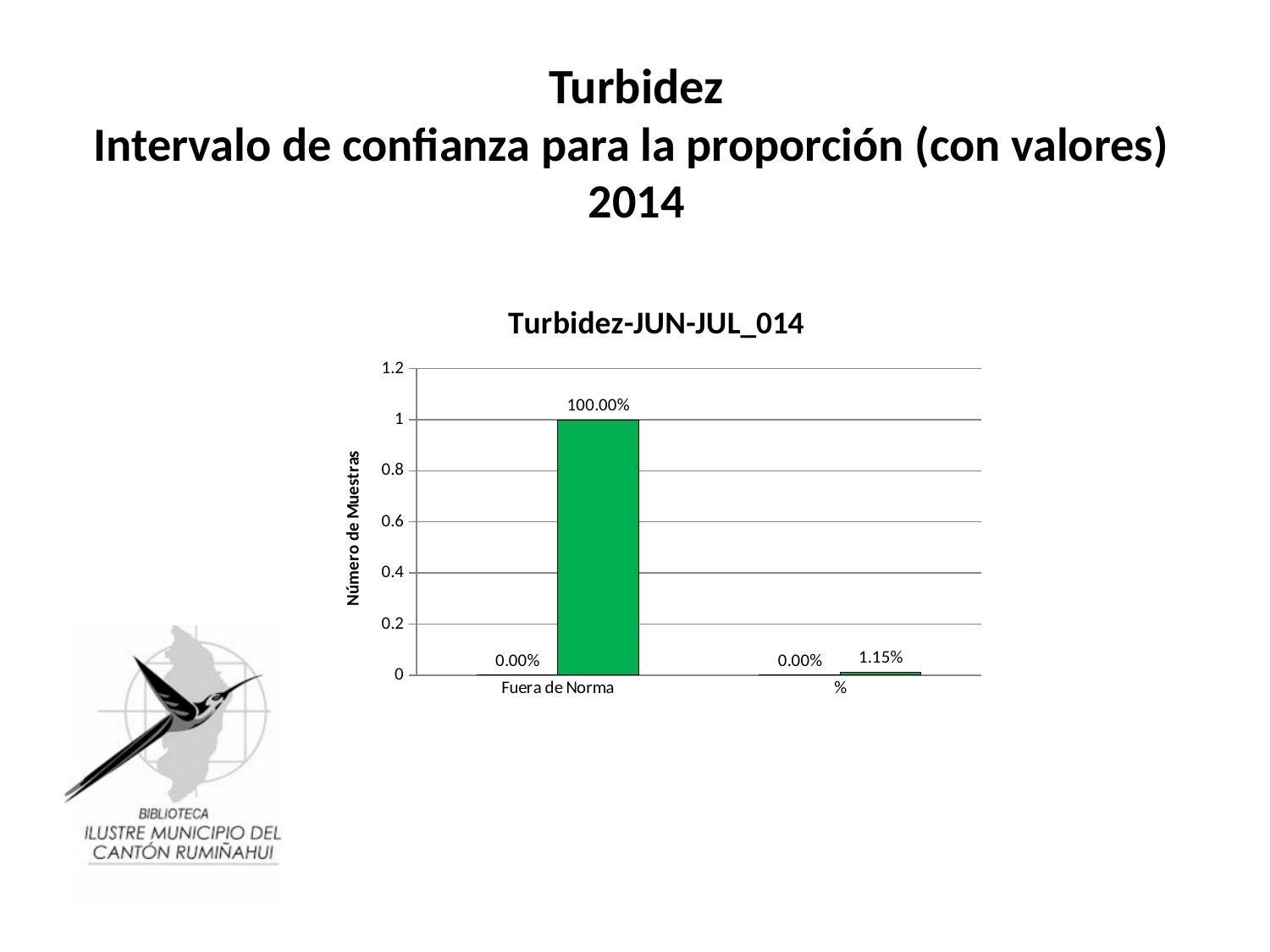
Which category has the larger green bar, 'Fuera de Norma' or '%'? Fuera de Norma What is the data label on the visible green bar in the '%' category? 1.15% Which category contains the tallest bar in the chart? Fuera de Norma What is the label on the vertical axis of the chart? Número de Muestras What is the difference between the data labels 100.00% and 1.15% shown on the chart? 98.85% How many categories are shown on the x axis of the chart? 2 What is the data label on the tallest bar in the chart? 100.00% How many data labels are printed on the chart? 4 Is the value of the tallest bar in the chart greater or less than 0.8 on the vertical axis? greater What is the highest tick value shown on the vertical axis of the chart? 1.2 What is the title of the chart? Turbidez-JUN-JUL_014 What kind of chart is shown on the slide? bar chart